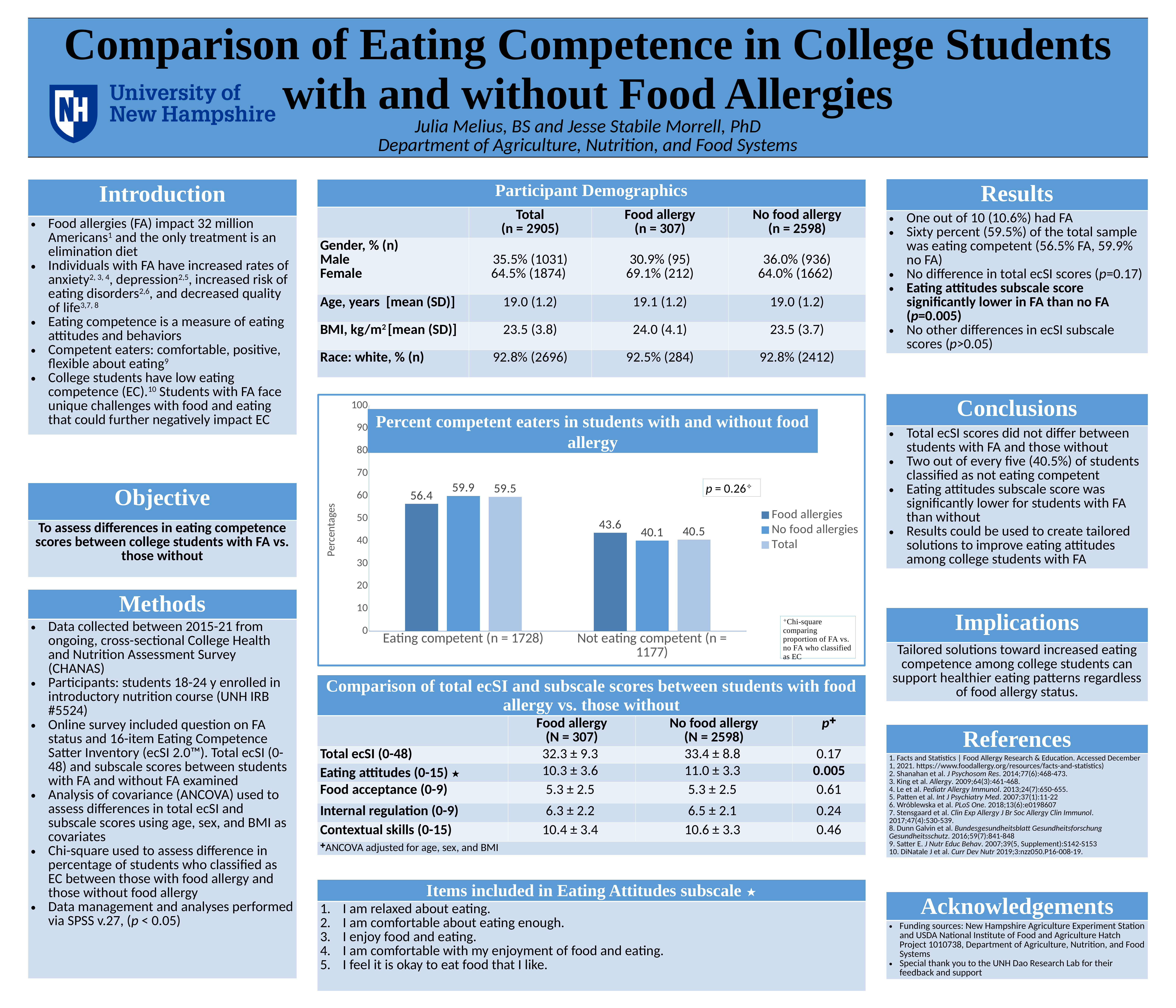
What is the value for Total in the Eating competent (n = 1728) category? 59.5 Which series has the lowest value in the Not eating competent (n = 1177) category? No food allergies Which is larger: the Food allergies value for Eating competent (n = 1728) or the Food allergies value for Not eating competent (n = 1177)? Eating competent (n = 1728) How many series does the chart legend list? 3 Which series has the highest value in the Eating competent (n = 1728) category? No food allergies What kind of chart is shown on the slide? bar chart What is the title of the chart? Percent competent eaters in students with and without food allergy What is the difference between the Food allergies and No food allergies values in the Eating competent (n = 1728) category? 3.5 What is the value for Food allergies in the Not eating competent (n = 1177) category? 43.6 What is the value for Food allergies in the Eating competent (n = 1728) category? 56.4 What is the value for No food allergies in the Not eating competent (n = 1177) category? 40.1 Is the Total value for Not eating competent (n = 1177) greater or less than 50? less